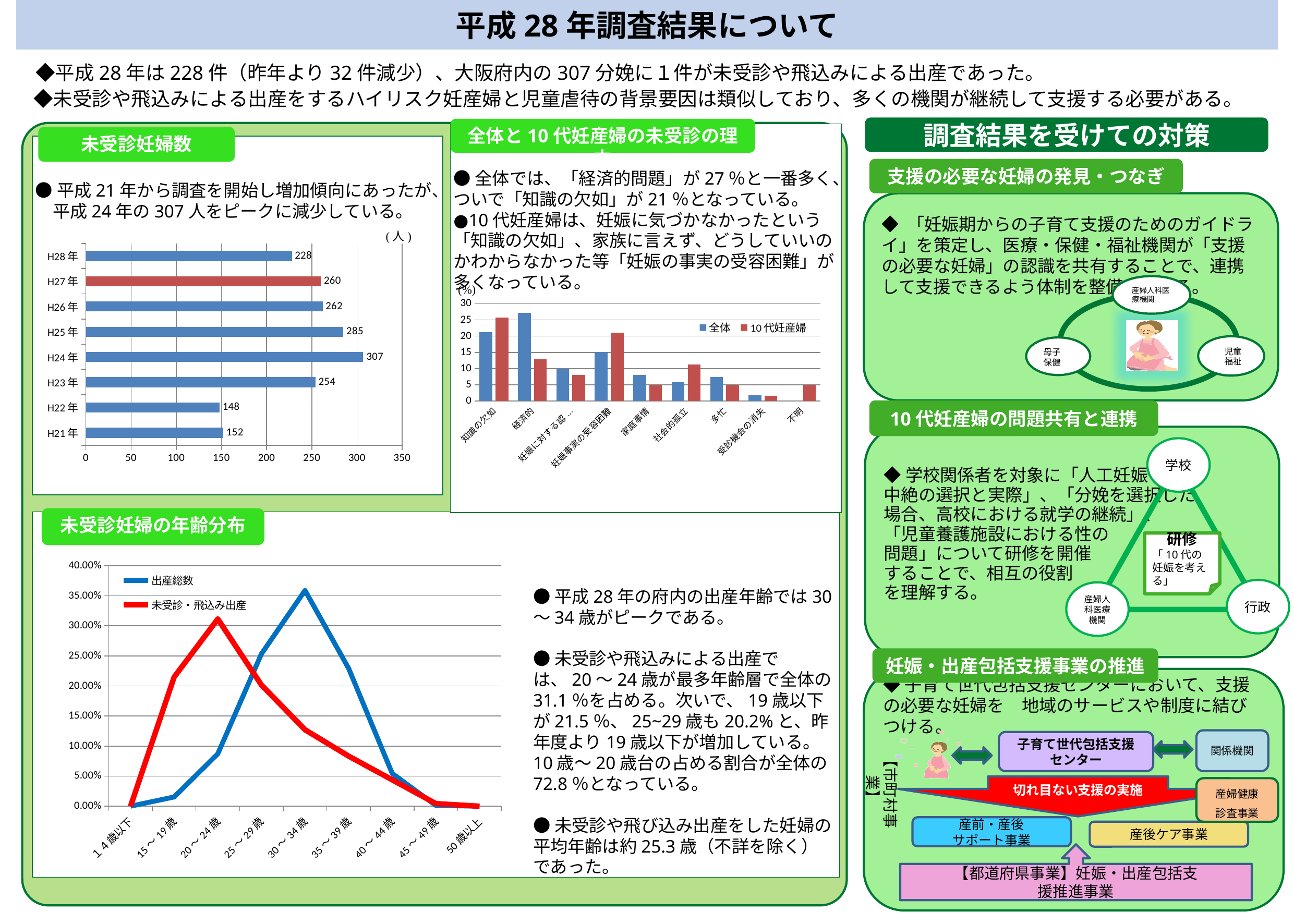
In the 未受診妊婦数 chart, what is the difference between the values for H24年 and H28年? 79 What kind of chart is the 未受診妊婦数 chart? bar chart In the 未受診妊婦数 chart, how many years are shown? 8 In the 未受診妊婦数 chart, which year has the highest value? H24年 In the 未受診妊婦の年齢分布 chart, which age group has the highest value for 出産総数? 30～34歳 In the 全体と10代妊産婦の未受診の理由 chart, how many series does the legend list? 2 In the 未受診妊婦の年齢分布 chart, is the 未受診・飛込み出産 value for 20～24歳 greater or less than 25.00%? greater In the 全体と10代妊産婦の未受診の理由 chart, is the 全体 value for 家庭事情 greater or less than 10? less In the 未受診妊婦数 chart, what is the value for H28年? 228 In the 未受診妊婦数 chart, what is the value for H24年? 307 In the 全体と10代妊産婦の未受診の理由 chart, which category has the highest 全体 value? 経済的 In the 未受診妊婦数 chart, which year has the lowest value? H22年